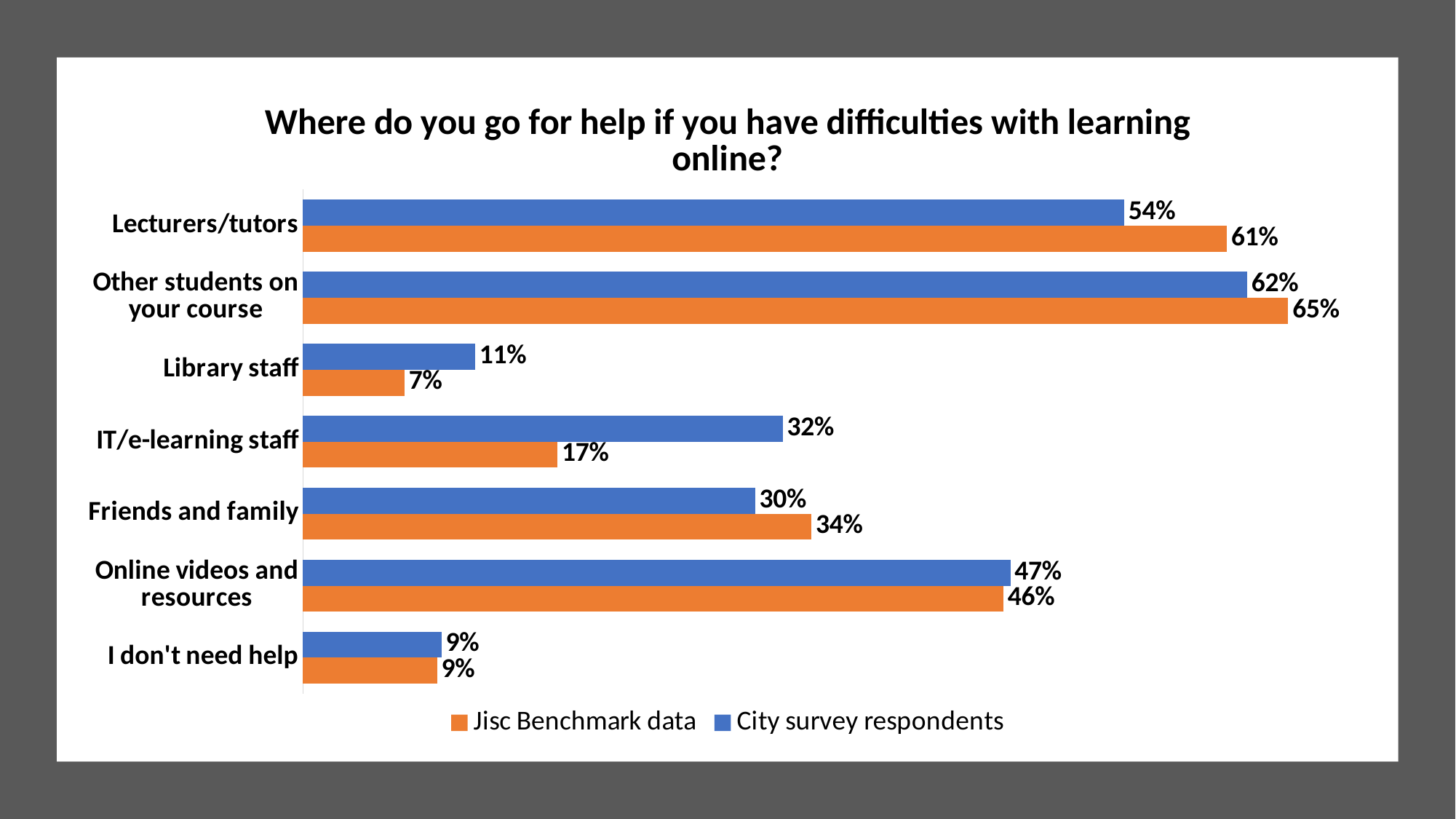
What kind of chart is shown on the slide? Bar chart What is the difference between the Jisc Benchmark data and City survey respondents values for IT/e-learning staff? 15% What is the City survey respondents value for IT/e-learning staff? 32% How many series does the legend list? 2 Which category has the lowest City survey respondents value? I don't need help How many categories are shown on the chart? 7 For Friends and family, which series has the larger value: Jisc Benchmark data or City survey respondents? Jisc Benchmark data What is the City survey respondents value for Lecturers/tutors? 54% What is the Jisc Benchmark data value for Library staff? 7% For Library staff, which series has the larger value: Jisc Benchmark data or City survey respondents? City survey respondents Which category has the highest Jisc Benchmark data value? Other students on your course What is the difference between the Jisc Benchmark data and City survey respondents values for Lecturers/tutors? 7%